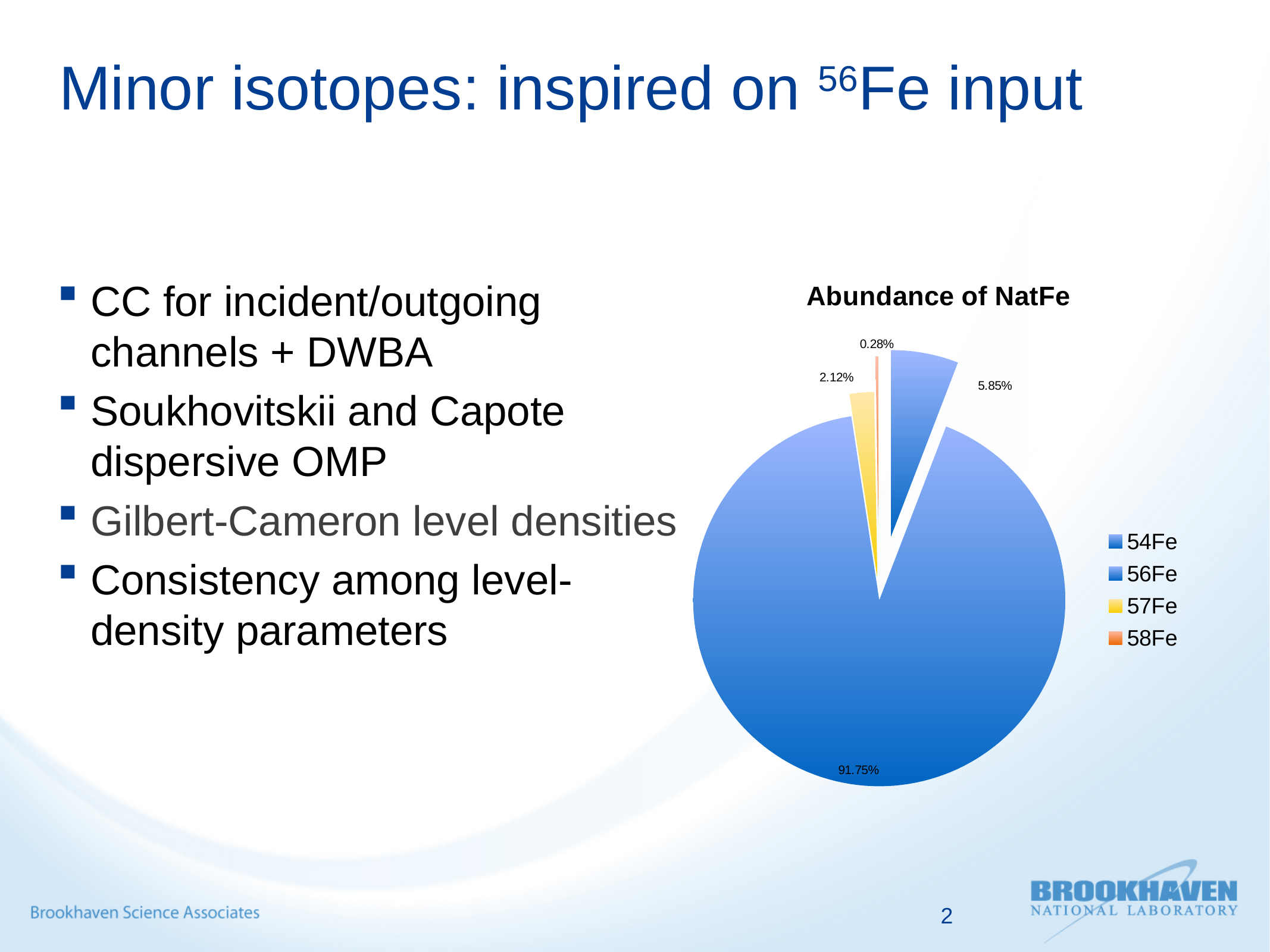
What type of chart is shown on the slide? pie chart What is the share of 57Fe in the pie chart? 2.12% What is the title of the chart? Abundance of NatFe What is the difference between the shares of 54Fe and 57Fe? 3.73% What is the share of 56Fe in the pie chart? 91.75% What is the share of 54Fe in the pie chart? 5.85% How many slices does the pie chart have? 4 How many entries does the chart legend list? 4 Which isotope has the smallest slice in the pie chart? 58Fe Which isotope has the largest slice in the pie chart? 56Fe Which is larger, the share of 54Fe or the share of 57Fe? 54Fe